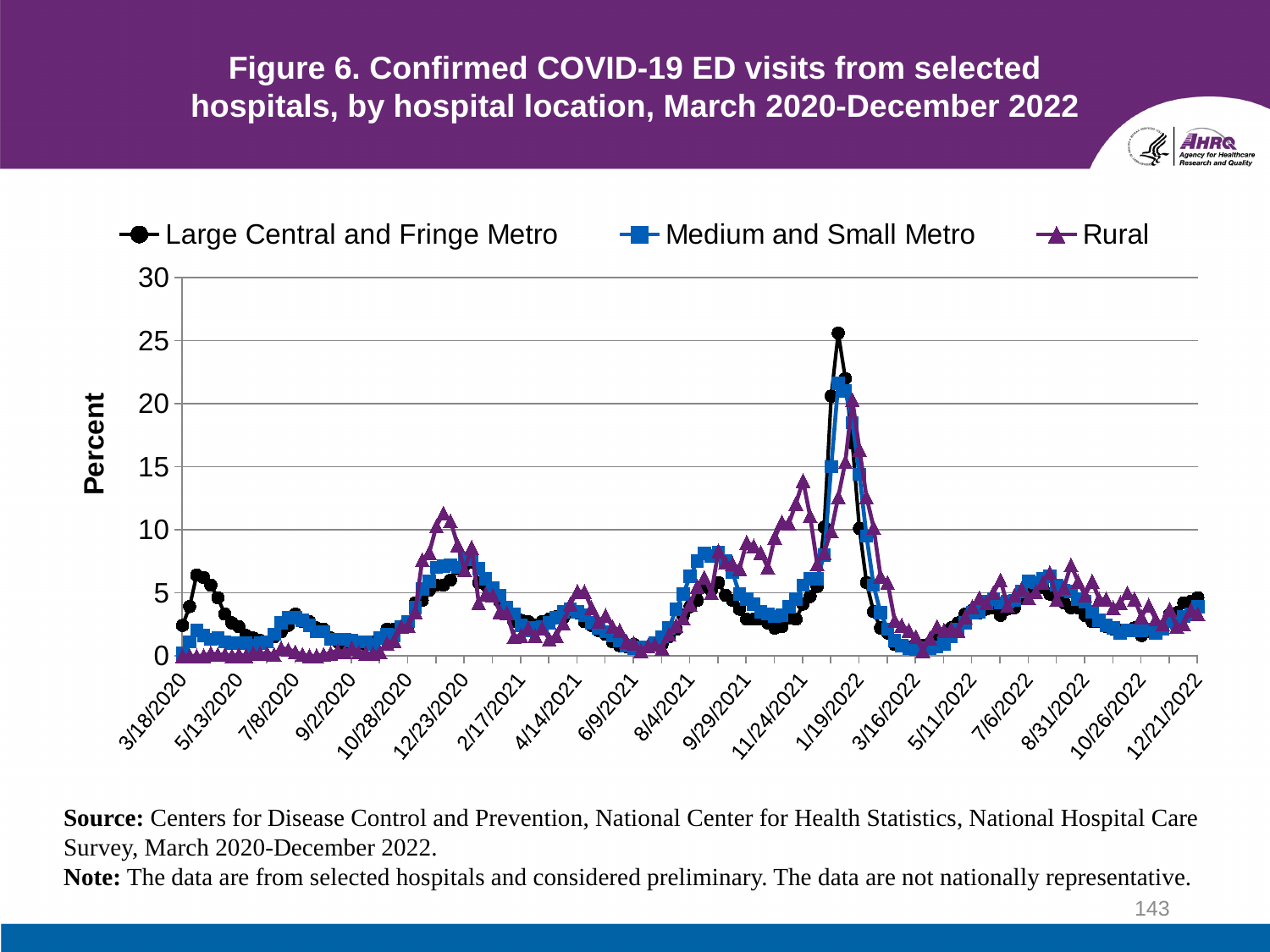
In spring 2020 (around 5/13/2020), which series has the higher value: Large Central and Fringe Metro or Rural? Large Central and Fringe Metro Is the peak value for Large Central and Fringe Metro around 1/19/2022 greater or less than 20? greater Is the value for Rural around 11/24/2021 greater or less than 10? greater Around 11/24/2021, which series has the higher value: Rural or Large Central and Fringe Metro? Rural What is the label on the vertical axis? Percent Which series reaches the highest peak on the chart? Large Central and Fringe Metro How many series does the legend list? 3 What kind of chart is shown on the slide? line chart What is the highest tick value shown on the vertical axis? 30 Is the value for Medium and Small Metro around 3/16/2022 greater or less than 5? less Do the values for all three series rise or fall between 1/19/2022 and 3/16/2022? fall